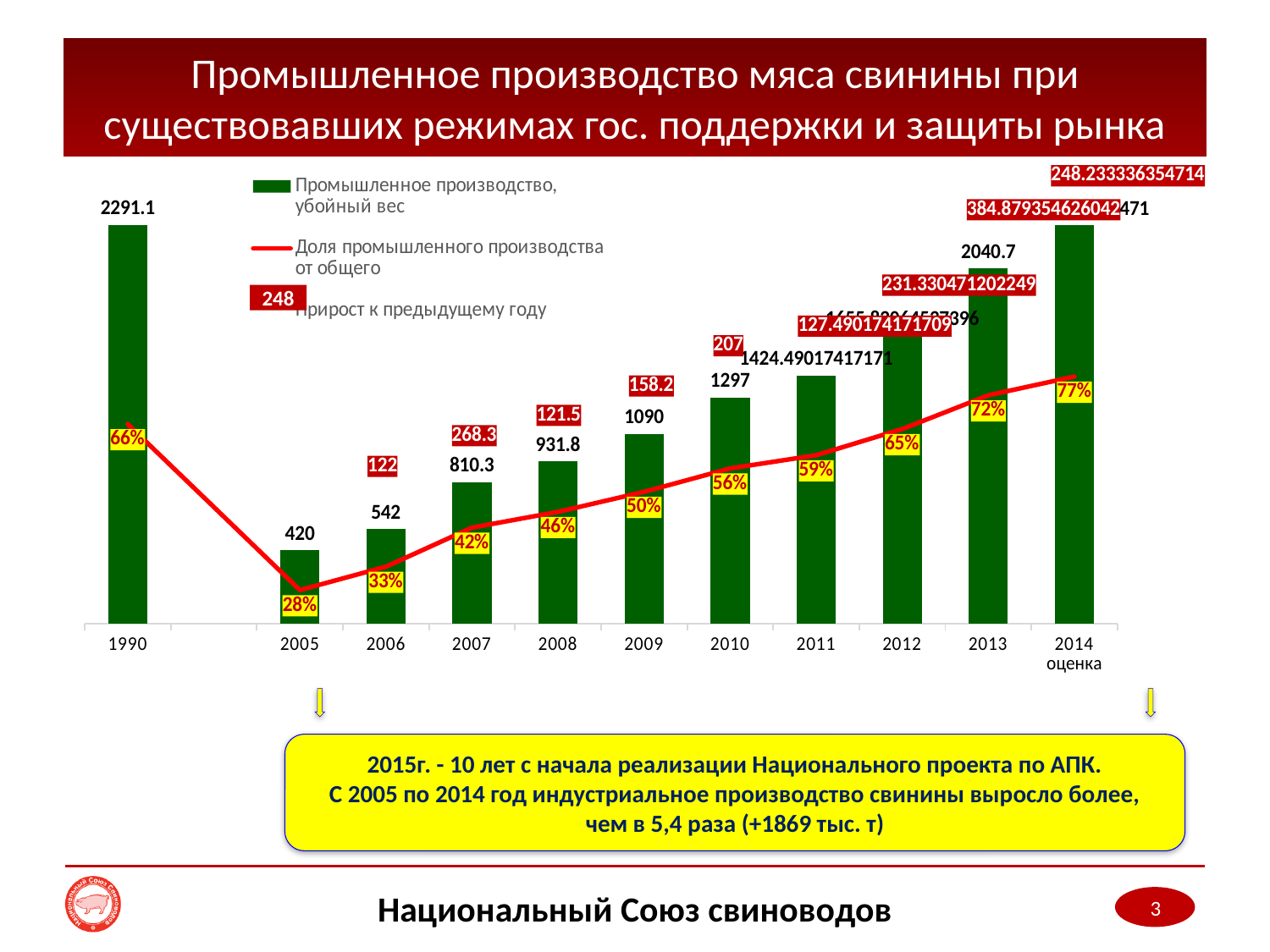
What is the industrial production value shown for 2009? 1090 Which year has the lowest industrial production bar? 2005 What share of total production (Доля промышленного производства от общего) is shown for 2013? 72% Which year has the larger industrial production value, 2006 or 2007? 2007 How many series does the legend list? 3 How many years are shown on the x axis? 11 Which year has the lowest share of industrial production in total production? 2005 What is the difference between the industrial production values for 2008 and 2007? 121.5 Does the share of industrial production rise or fall from 2005 to 2014? rises What share of total production is shown for 2005? 28% What is the industrial pork production (убойный вес) value shown for 2005? 420 What is the growth over the previous year (Прирост к предыдущему году) shown for 2009? 158.2